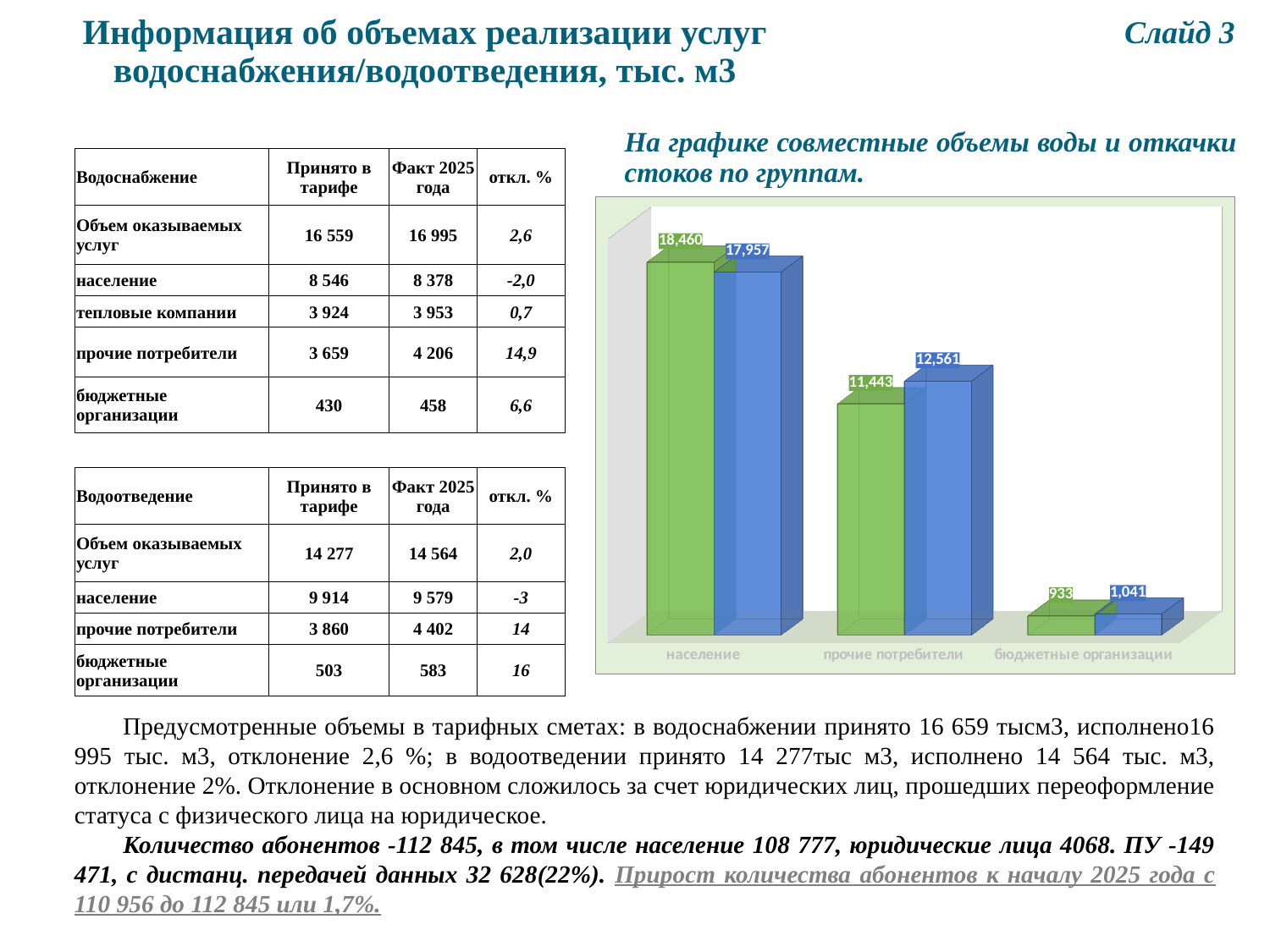
What is the value of the blue bar for бюджетные организации? 1,041 For население, which bar is larger, the green one or the blue one? green What is the value of the green bar for прочие потребители? 11,443 What is the value of the blue bar for население? 17,957 What is the difference between the blue and green bars for прочие потребители? 1,118 How many categories are shown on the x axis of the chart? 3 What is the value of the blue bar for прочие потребители? 12,561 What is the value of the green bar for бюджетные организации? 933 What kind of chart is shown on the slide? bar chart What is the value of the green bar for население? 18,460 Which category has the highest green bar? население Which category has the lowest blue bar? бюджетные организации